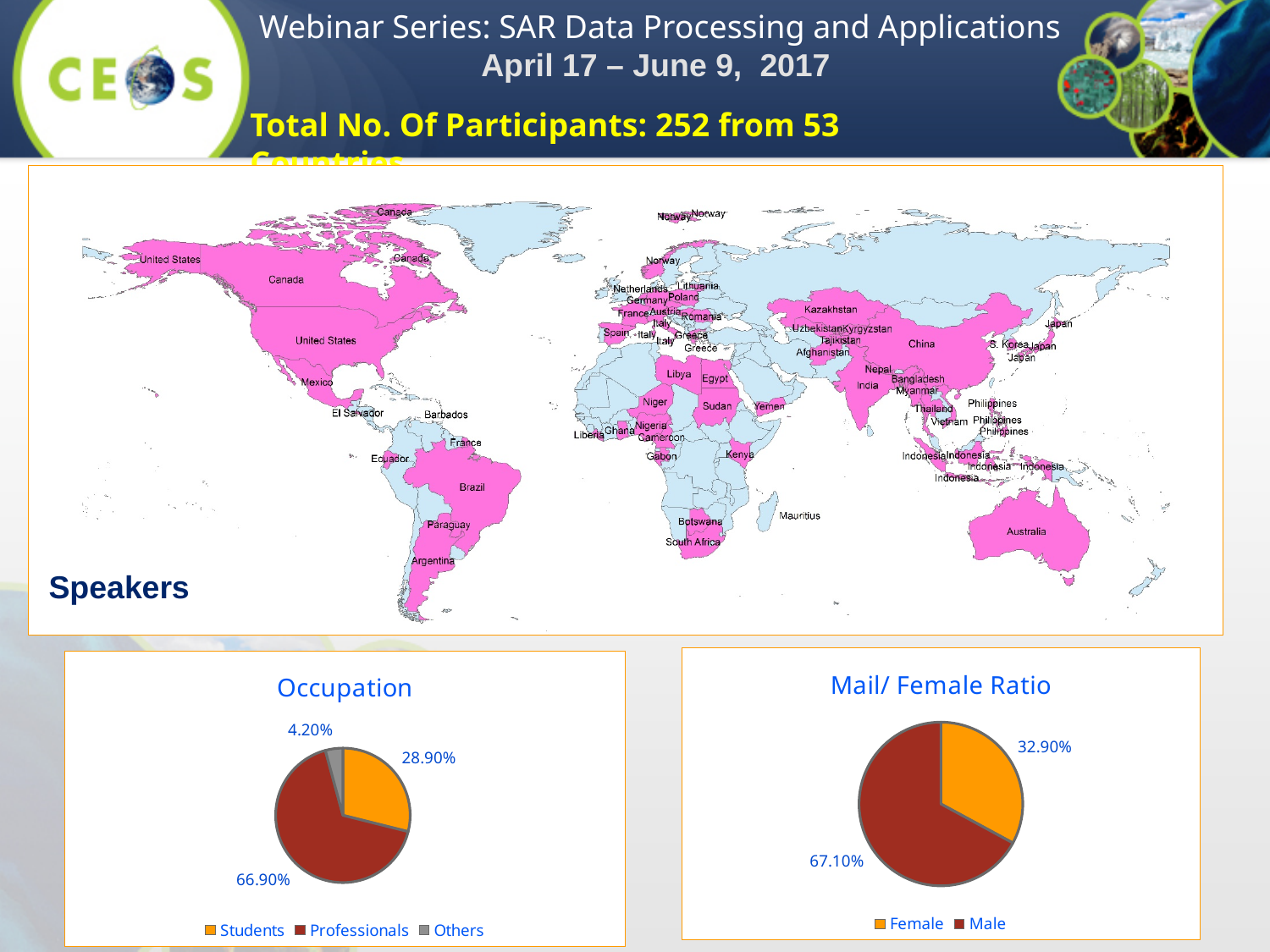
In the Mail/ Female Ratio chart, what colour represents Female? Orange In the Mail/ Female Ratio chart, which is larger, the Male share or the Female share? Male In the Occupation chart, what share of participants are Professionals? 66.90% In the Occupation chart, what share of participants are Others? 4.20% In the Occupation chart, how many categories does the legend list? 3 In the Occupation chart, which category has the largest share? Professionals What type of chart is the Occupation chart? Pie chart In the Occupation chart, what share of participants are Students? 28.90% In the Occupation chart, which category has the smallest share? Others In the Mail/ Female Ratio chart, what share is Male? 67.10% In the Occupation chart, what is the difference between the Professionals share and the Students share? 38.00% In the Mail/ Female Ratio chart, what share is Female? 32.90%